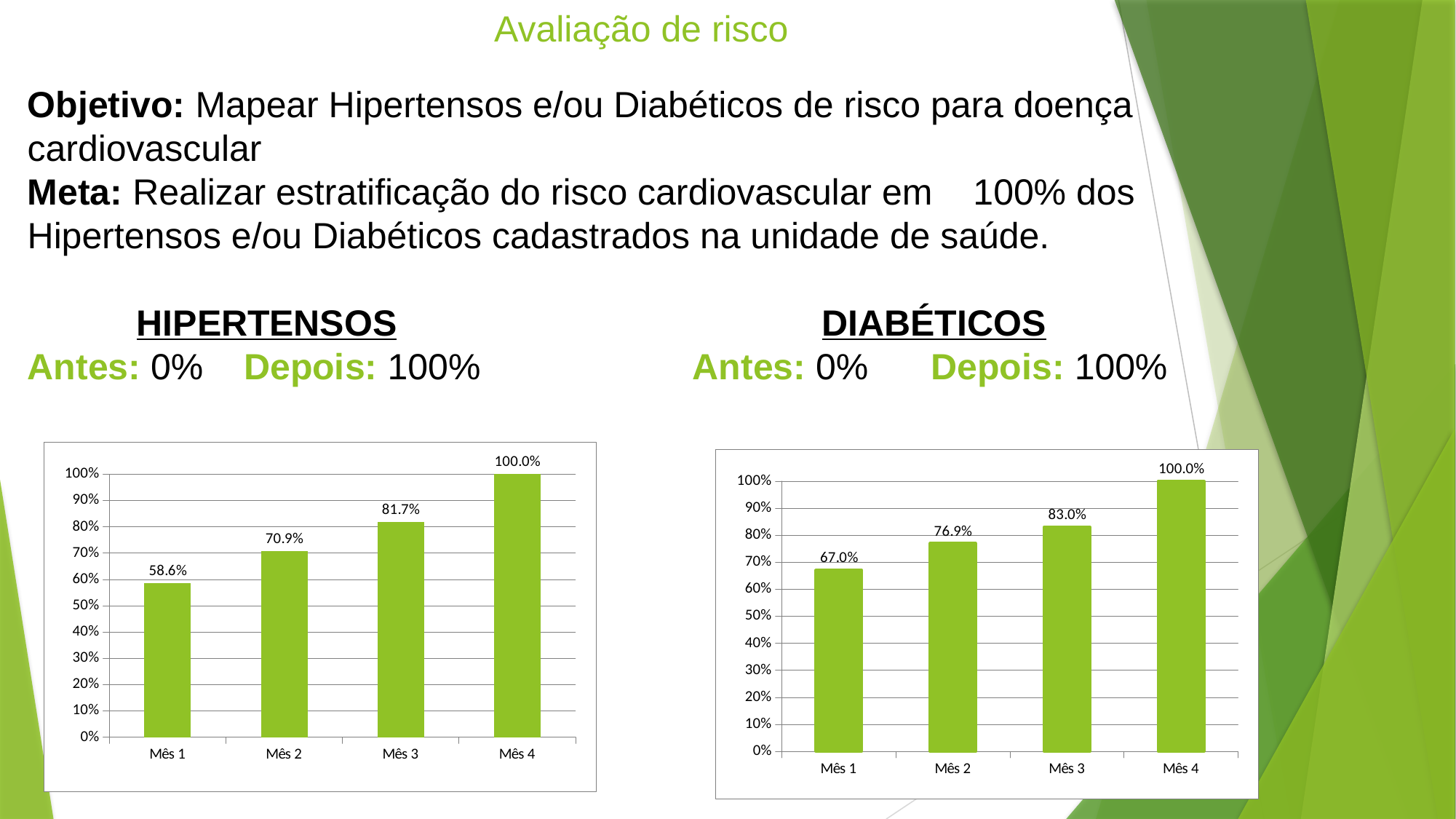
What kind of chart is the HIPERTENSOS chart (left)? Bar chart What colour are the bars in the HIPERTENSOS chart (left)? Green In the HIPERTENSOS chart (left), what is the difference between Mês 3 and Mês 2? 10.8% In the DIABÉTICOS chart (right), what is the value for Mês 2? 76.9% In the HIPERTENSOS chart (left), which month has the lowest value? Mês 1 In the HIPERTENSOS chart (left), what is the value for Mês 1? 58.6% In the HIPERTENSOS chart (left), is the value for Mês 2 greater or less than 60%? greater How many months are shown in the DIABÉTICOS chart (right)? 4 Which is larger: Mês 3 in the HIPERTENSOS chart (left) or Mês 3 in the DIABÉTICOS chart (right)? Mês 3 in the DIABÉTICOS chart In the DIABÉTICOS chart (right), which month has the highest value? Mês 4 In the DIABÉTICOS chart (right), do the values rise or fall from Mês 1 to Mês 4? Rise In the DIABÉTICOS chart (right), what is the difference between Mês 4 and Mês 1? 33.0%